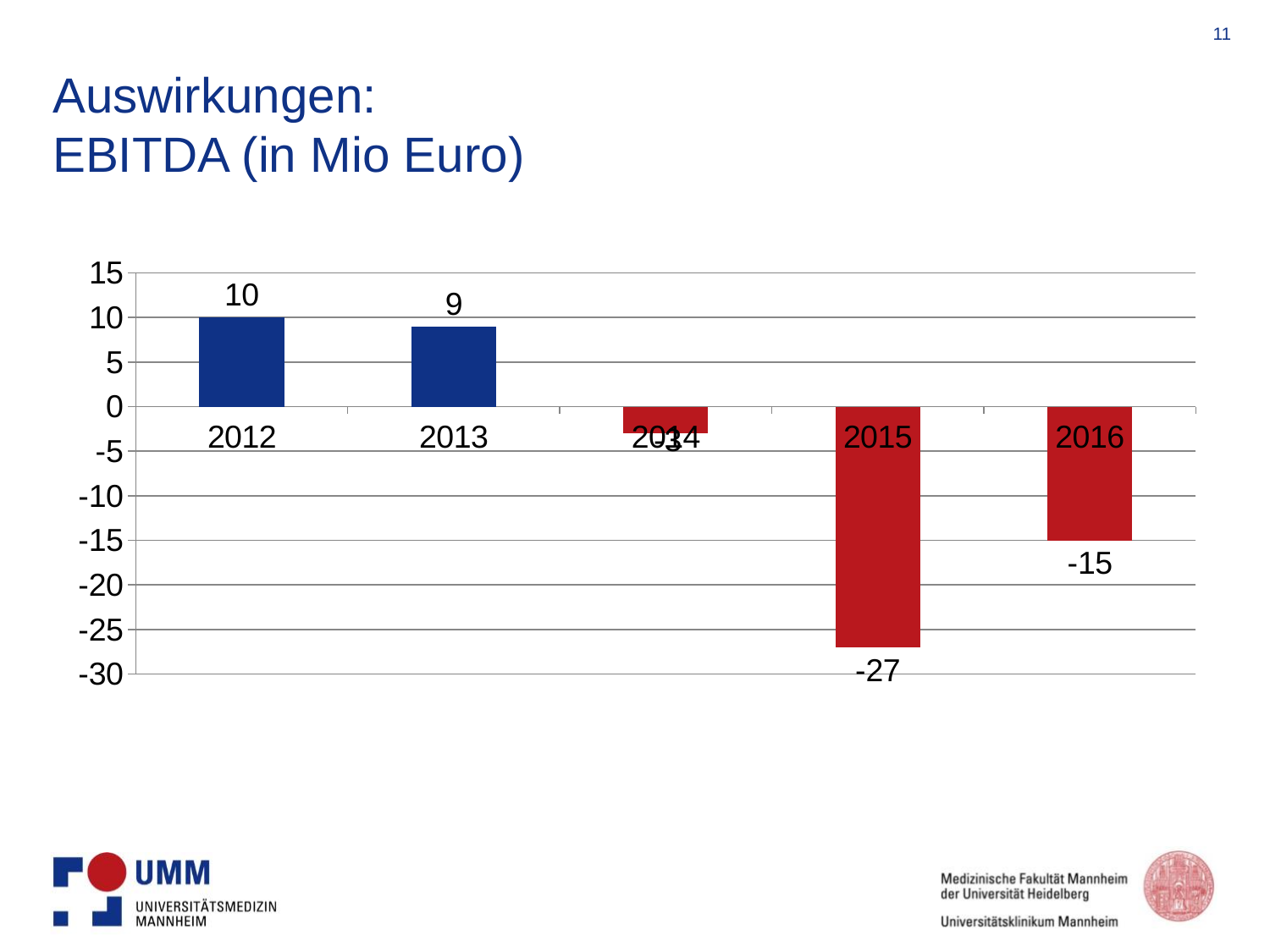
What kind of chart is shown on the slide? bar chart What is the EBITDA value for 2013? 9 Is the value for 2014 greater or less than -5? greater What is the EBITDA value for 2016? -15 Which year has the highest EBITDA? 2012 Which year has the lowest EBITDA? 2015 What is the difference between the EBITDA values for 2012 and 2013? 1 What is the EBITDA value for 2012? 10 How many years are shown on the x axis of the chart? 5 What is the EBITDA value for 2015? -27 What is the difference between the EBITDA values for 2015 and 2016? 12 Which year has the larger EBITDA, 2015 or 2016? 2016